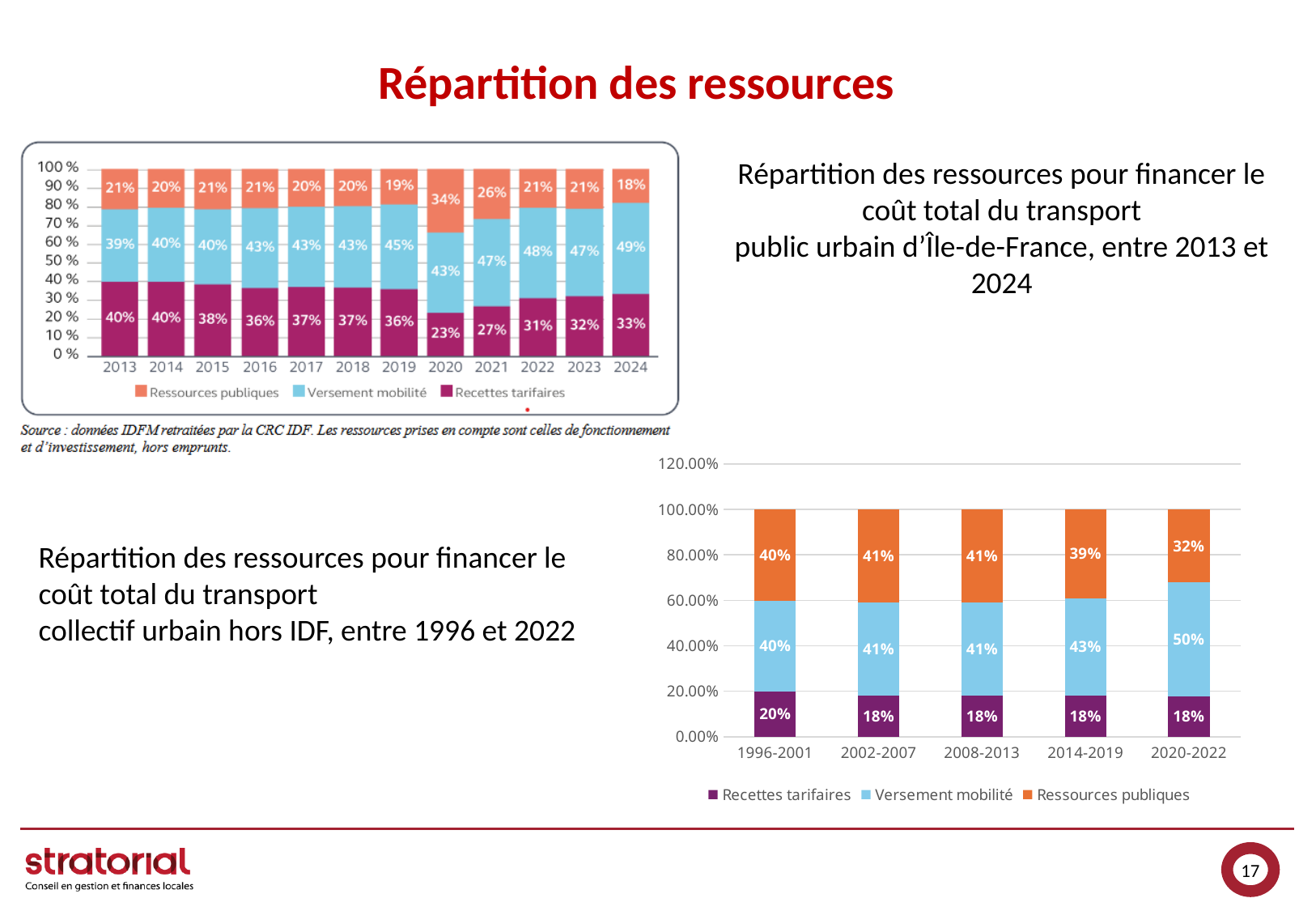
In the top-left chart (Île-de-France, 2013–2024), what is the value for Versement mobilité in 2024? 49% In the top-left chart (Île-de-France, 2013–2024), which year has the highest value for Ressources publiques? 2020 In the top-left chart (Île-de-France, 2013–2024), how many years are shown on the x axis? 12 In the bottom-right chart (hors IDF, 1996–2022), which period has the lowest value for Ressources publiques? 2020-2022 In the top-left chart (Île-de-France, 2013–2024), what is the value for Ressources publiques in 2020? 34% In the top-left chart (Île-de-France, 2013–2024), what is the difference between the Recettes tarifaires value in 2013 and in 2024? 7% In the bottom-right chart (hors IDF, 1996–2022), what is the value for Recettes tarifaires in 1996-2001? 20% In the top-left chart (Île-de-France, 2013–2024), what is the value for Recettes tarifaires in 2020? 23% In the top-left chart (Île-de-France, 2013–2024), which year has the lowest value for Recettes tarifaires? 2020 In the bottom-right chart (hors IDF, 1996–2022), what is the value for Versement mobilité in 2020-2022? 50% What kind of chart is the bottom-right chart (hors IDF, 1996–2022)? Stacked bar chart In the bottom-right chart (hors IDF, 1996–2022), how many series does the legend list? 3